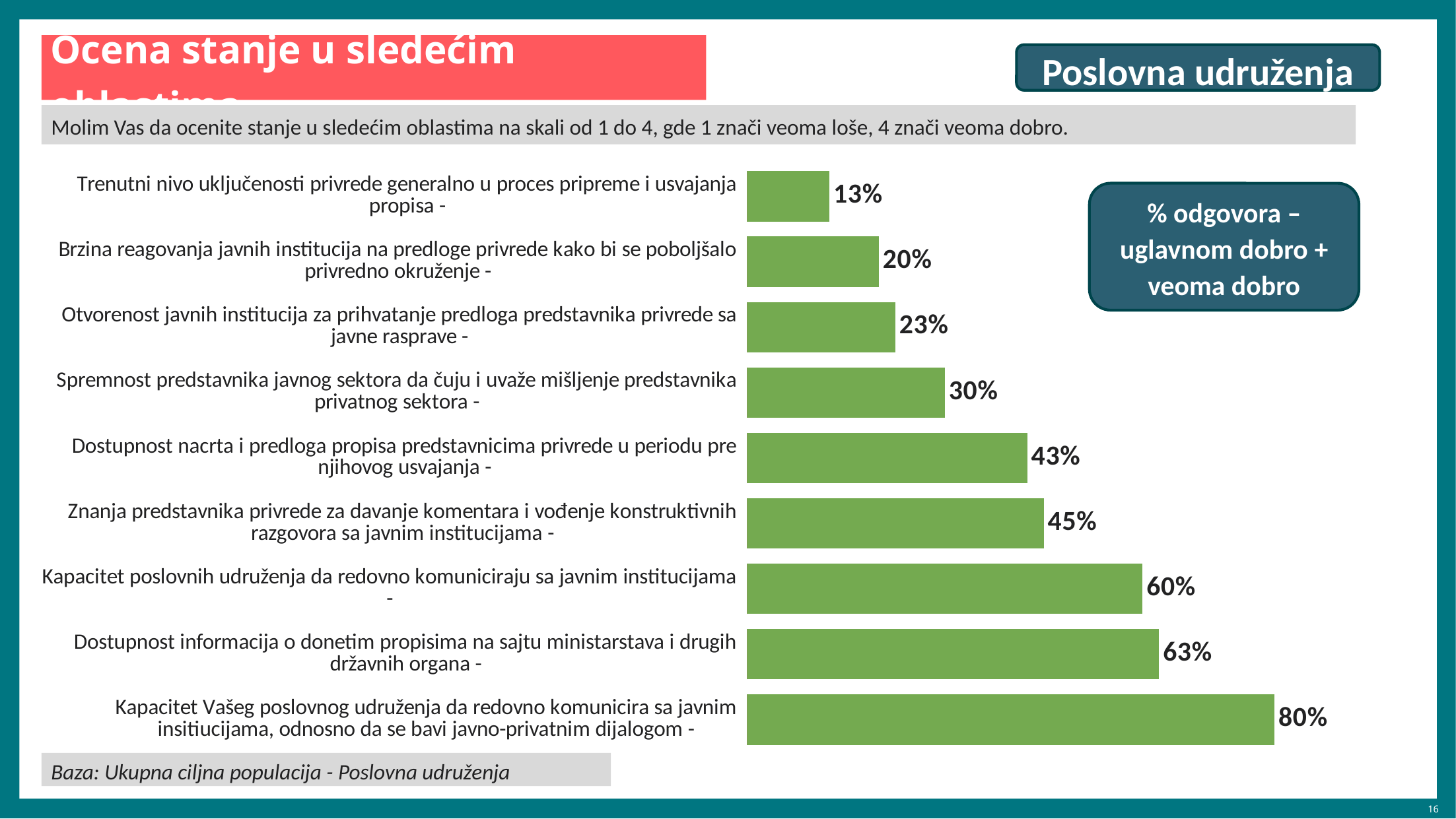
Which category has the lowest value? Trenutni nivo uključenosti privrede generalno u proces pripreme i usvajanja propisa What value is shown for "Dostupnost informacija o donetim propisima na sajtu ministarstava i drugih državnih organa"? 63% According to the label on the slide, what do the percentages in the chart represent? % odgovora – uglavnom dobro + veoma dobro Which is larger: the value for "Dostupnost nacrta i predloga propisa predstavnicima privrede u periodu pre njihovog usvajanja" or the value for "Otvorenost javnih institucija za prihvatanje predloga predstavnika privrede sa javne rasprave"? Dostupnost nacrta i predloga propisa predstavnicima privrede u periodu pre njihovog usvajanja What is the difference between the highest and lowest values in the chart? 67% What percentage is shown for "Spremnost predstavnika javnog sektora da čuju i uvaže mišljenje predstavnika privatnog sektora"? 30% What is the difference between the value for "Kapacitet poslovnih udruženja da redovno komuniciraju sa javnim institucijama" and the value for "Brzina reagovanja javnih institucija na predloge privrede kako bi se poboljšalo privredno okruženje"? 40% What percentage is shown for "Trenutni nivo uključenosti privrede generalno u proces pripreme i usvajanja propisa"? 13% What kind of chart is shown on the slide? Bar chart How many categories are plotted in the chart? 9 What value is shown for "Znanja predstavnika privrede za davanje komentara i vođenje konstruktivnih razgovora sa javnim institucijama"? 45% Which category has the highest value? Kapacitet Vašeg poslovnog udruženja da redovno komunicira sa javnim insitiucijama, odnosno da se bavi javno-privatnim dijalogom